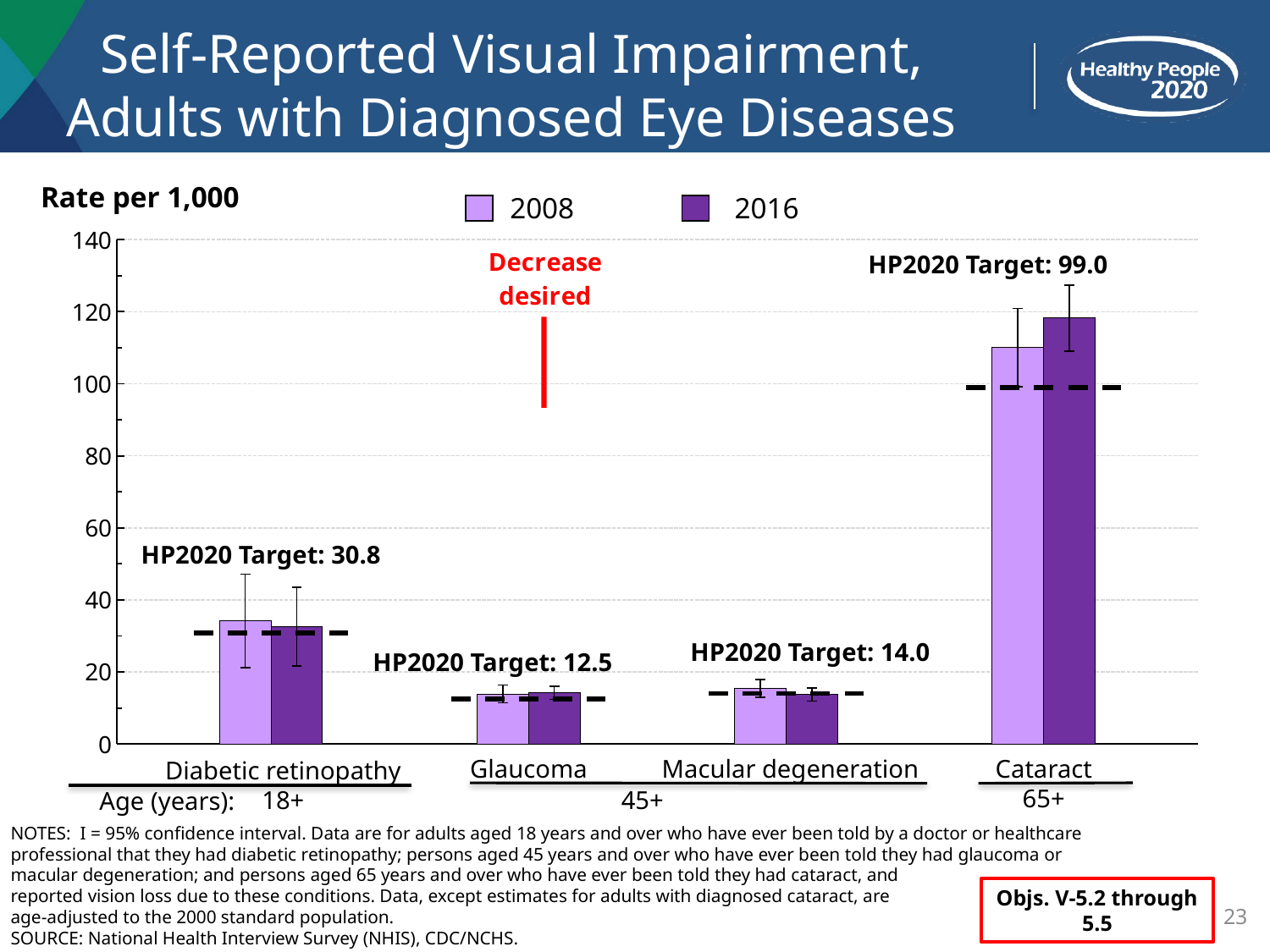
What is the HP2020 Target shown for Macular degeneration? 14.0 How many eye disease categories are shown on the x axis? 4 Which direction of change is labelled as desired on the chart? Decrease desired What kind of chart is shown on the slide? Bar chart What is the HP2020 Target shown for Diabetic retinopathy? 30.8 What is the HP2020 Target shown for Cataract? 99.0 Which eye disease category has the highest rate per 1,000? Cataract For Cataract, which year has the larger value, 2008 or 2016? 2016 Is the 2016 value for Cataract greater or less than 100? greater Is the 2008 value for Glaucoma greater or less than 20? less How many series does the legend list? 2 What is the HP2020 Target shown for Glaucoma? 12.5